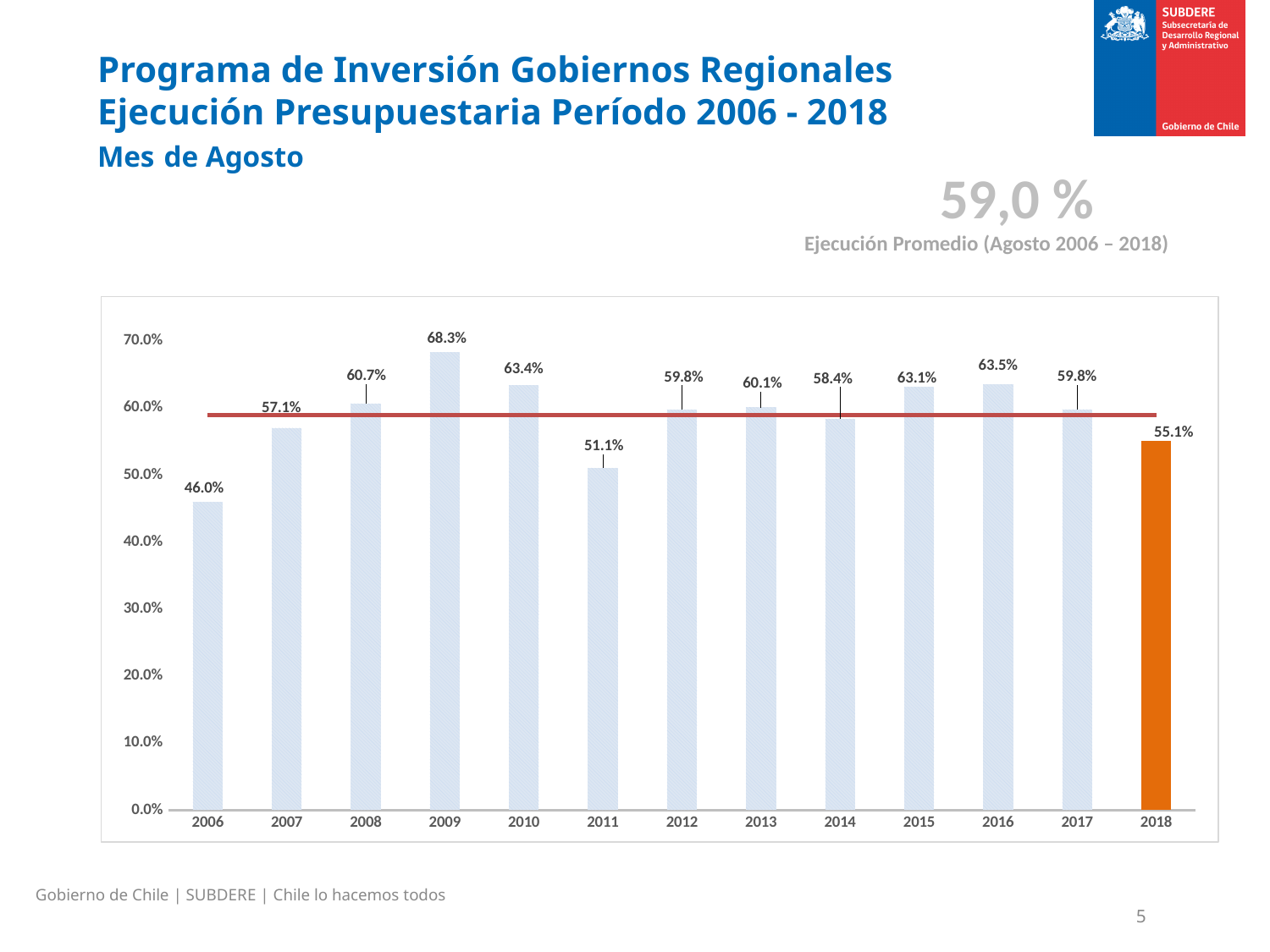
Which year has the lowest value? 2006 Is the value for 2014 greater or less than 50.0%? greater Which year has the highest value? 2009 How many years are shown on the x axis? 13 What is the value for 2011? 51.1% What is the difference between the values for 2009 and 2006? 22.3% What average execution value is shown above the chart for August 2006 – 2018? 59,0 % Do the values rise or fall from 2006 to 2009? rise What kind of chart is shown on the slide? bar chart What is the value for 2018? 55.1% Which is larger, the value for 2016 or the value for 2017? 2016 What is the value for 2009? 68.3%